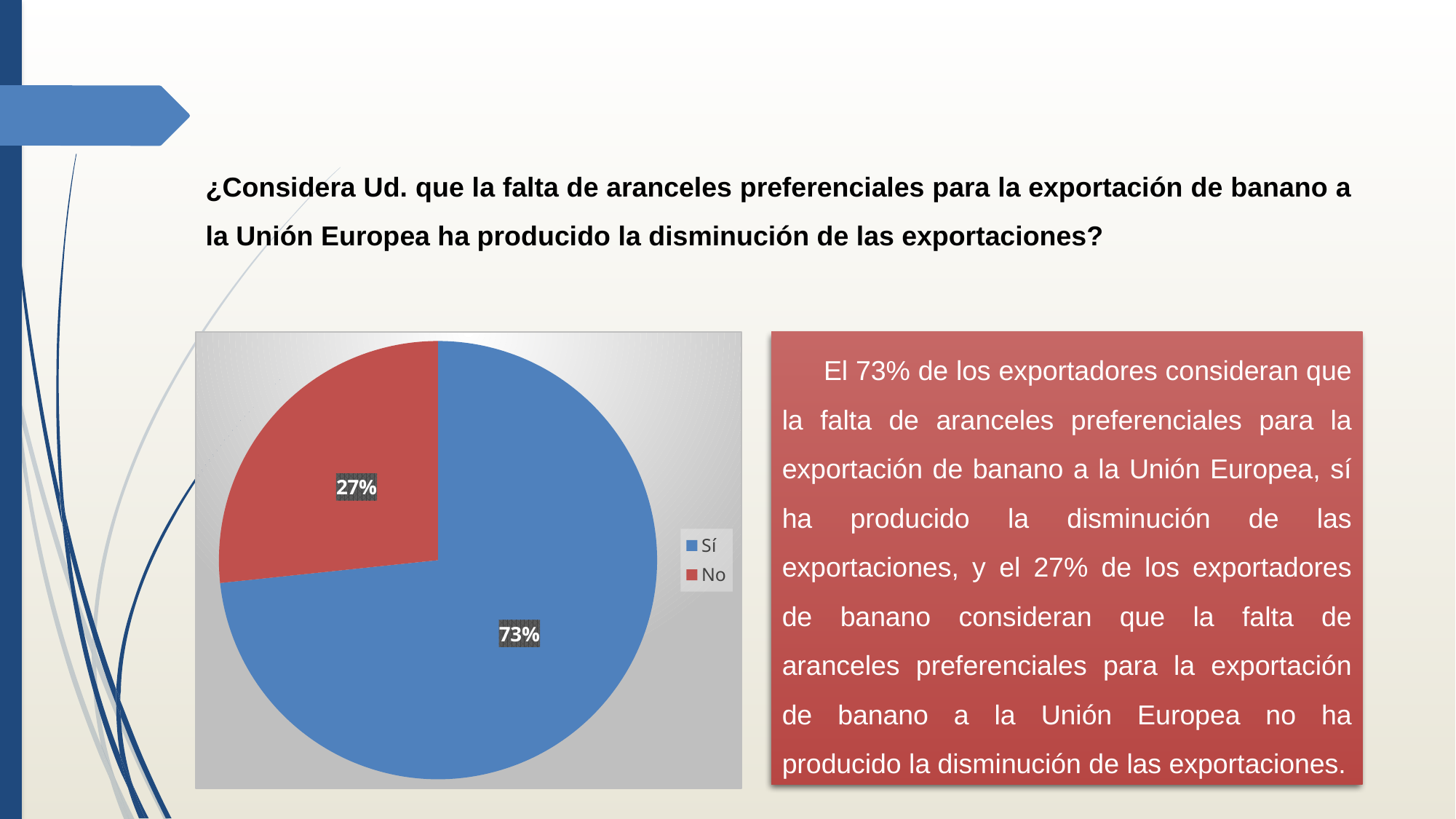
What share of the pie does the "No" slice represent? 27% What is the difference in percentage points between the "Sí" and "No" slices? 46 Which slice is larger, "Sí" or "No"? Sí How many entries does the legend of the pie chart list? 2 What percentage of the pie chart corresponds to "No"? 27% What percentage of the pie chart corresponds to "Sí"? 73% What colour is the "Sí" slice in the pie chart? blue How many slices does the pie chart have? 2 Which category has the largest slice in the pie chart? Sí What kind of chart is shown on the slide? pie chart Which category has the smallest slice in the pie chart? No What colour is the "No" slice in the pie chart? red